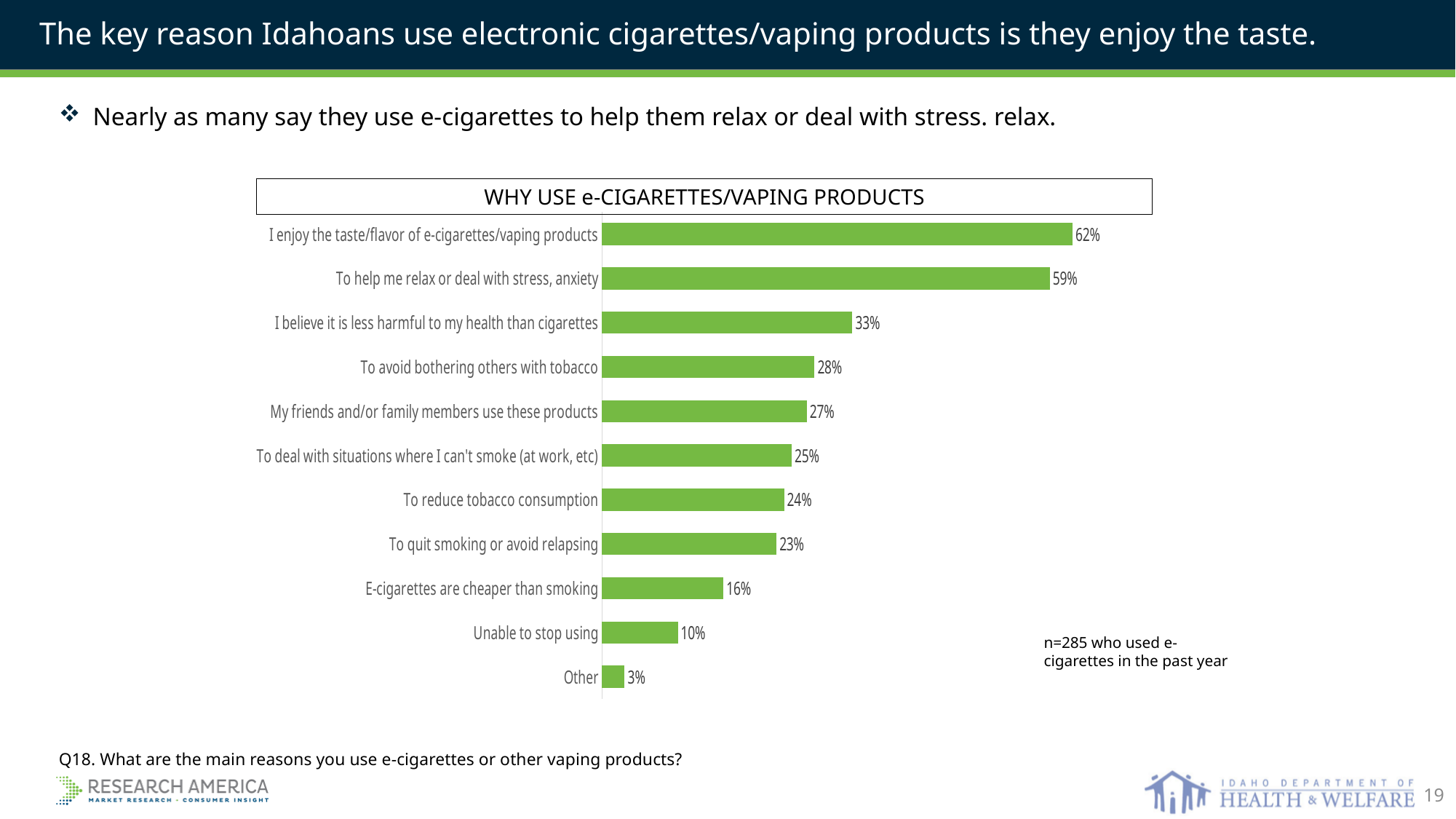
Which is larger: the value for 'To reduce tobacco consumption' or the value for 'To quit smoking or avoid relapsing'? To reduce tobacco consumption What percentage of respondents say they use e-cigarettes because they enjoy the taste/flavor? 62% What is the difference in percentage points between 'I enjoy the taste/flavor' and 'To help me relax or deal with stress, anxiety'? 3 percentage points What type of chart is shown on the slide? Bar chart Which reason has the highest percentage in the chart? I enjoy the taste/flavor of e-cigarettes/vaping products What is the sample size noted on the chart? n=285 who used e-cigarettes in the past year What percentage say e-cigarettes are cheaper than smoking? 16% What is the title of the chart? WHY USE e-CIGARETTES/VAPING PRODUCTS How many reasons (categories) are shown in the chart? 11 What percentage say they use e-cigarettes to help them relax or deal with stress, anxiety? 59% Which reason has the lowest percentage in the chart? Other What is the value for 'To avoid bothering others with tobacco'? 28%